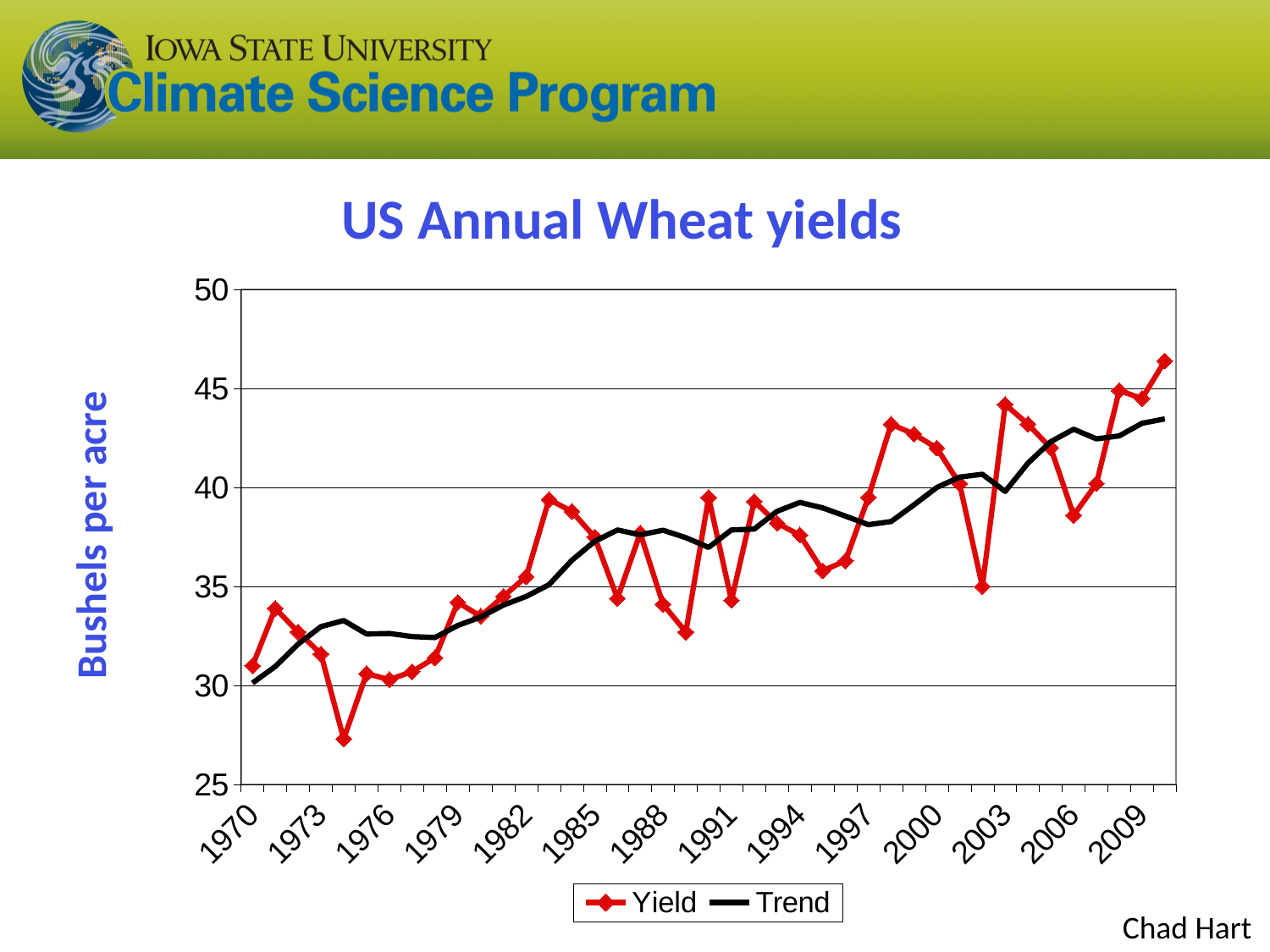
What is the title of the chart? US Annual Wheat yields Is the Yield value for 2006 greater or less than 40? less Is the Yield value for 1985 greater or less than 35? greater In 2006, which series has the higher value, Yield or Trend? Trend Is the Yield value for 1970 greater or less than 35? less What is the label on the vertical axis? Bushels per acre Does the Trend line generally rise or fall from 1970 to 2009? rise What kind of chart is shown on the slide? line chart How many series does the legend list? 2 Which year has the higher Yield value, 2003 or 2006? 2003